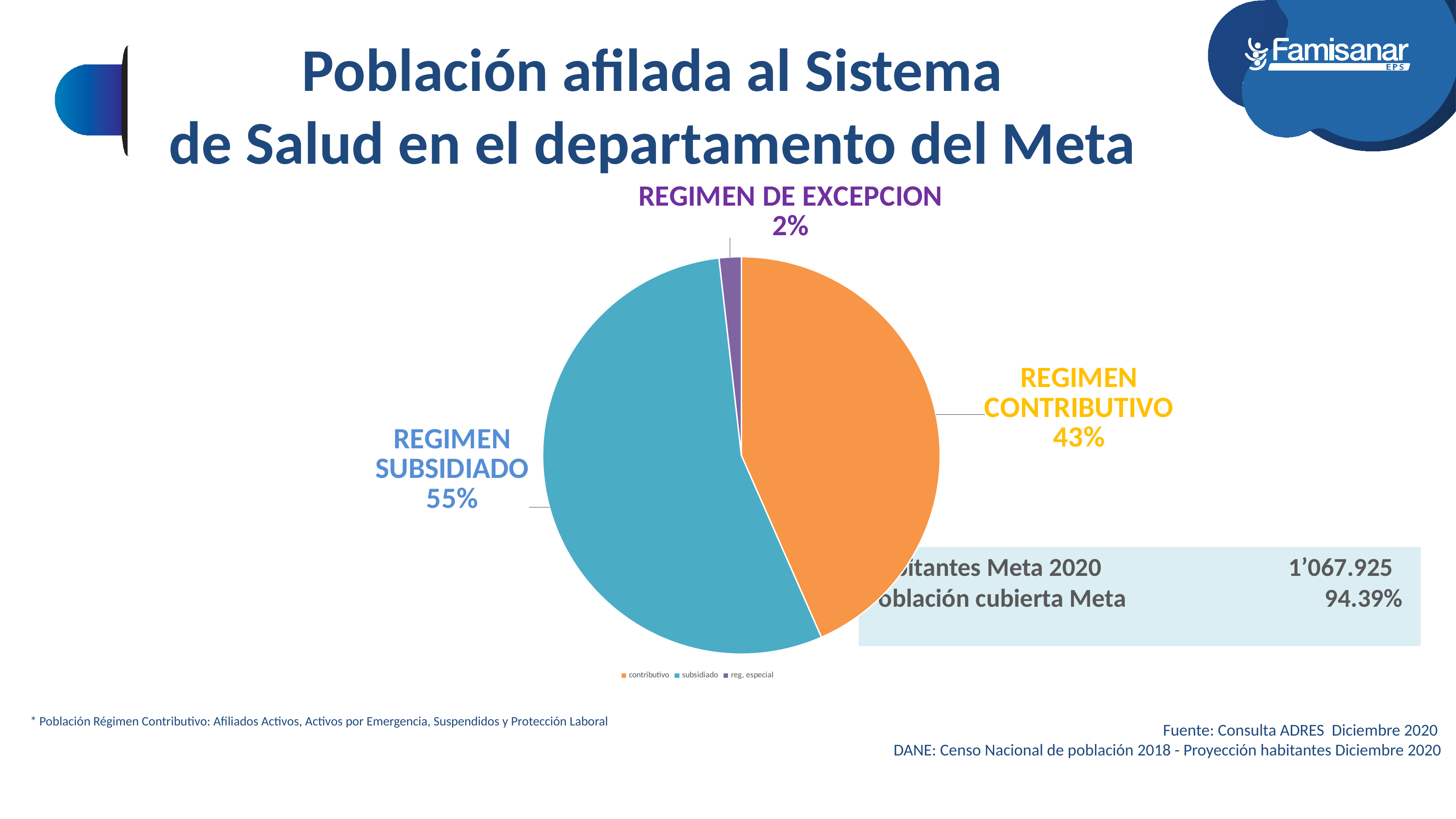
What share of the pie does REGIMEN SUBSIDIADO represent? 55% What share of the pie does REGIMEN DE EXCEPCION represent? 2% Which regime has the largest slice of the pie? REGIMEN SUBSIDIADO Which is larger, the share for REGIMEN CONTRIBUTIVO or REGIMEN DE EXCEPCION? REGIMEN CONTRIBUTIVO How many slices does the pie chart have? 3 How many entries does the chart legend list? 3 What colour is the REGIMEN CONTRIBUTIVO slice? Orange What type of chart is shown on the slide? Pie chart Which regime has the smallest slice of the pie? REGIMEN DE EXCEPCION What colour is the REGIMEN SUBSIDIADO slice? Teal blue What share of the pie does REGIMEN CONTRIBUTIVO represent? 43% What is the difference in percentage points between REGIMEN SUBSIDIADO and REGIMEN CONTRIBUTIVO? 12 percentage points